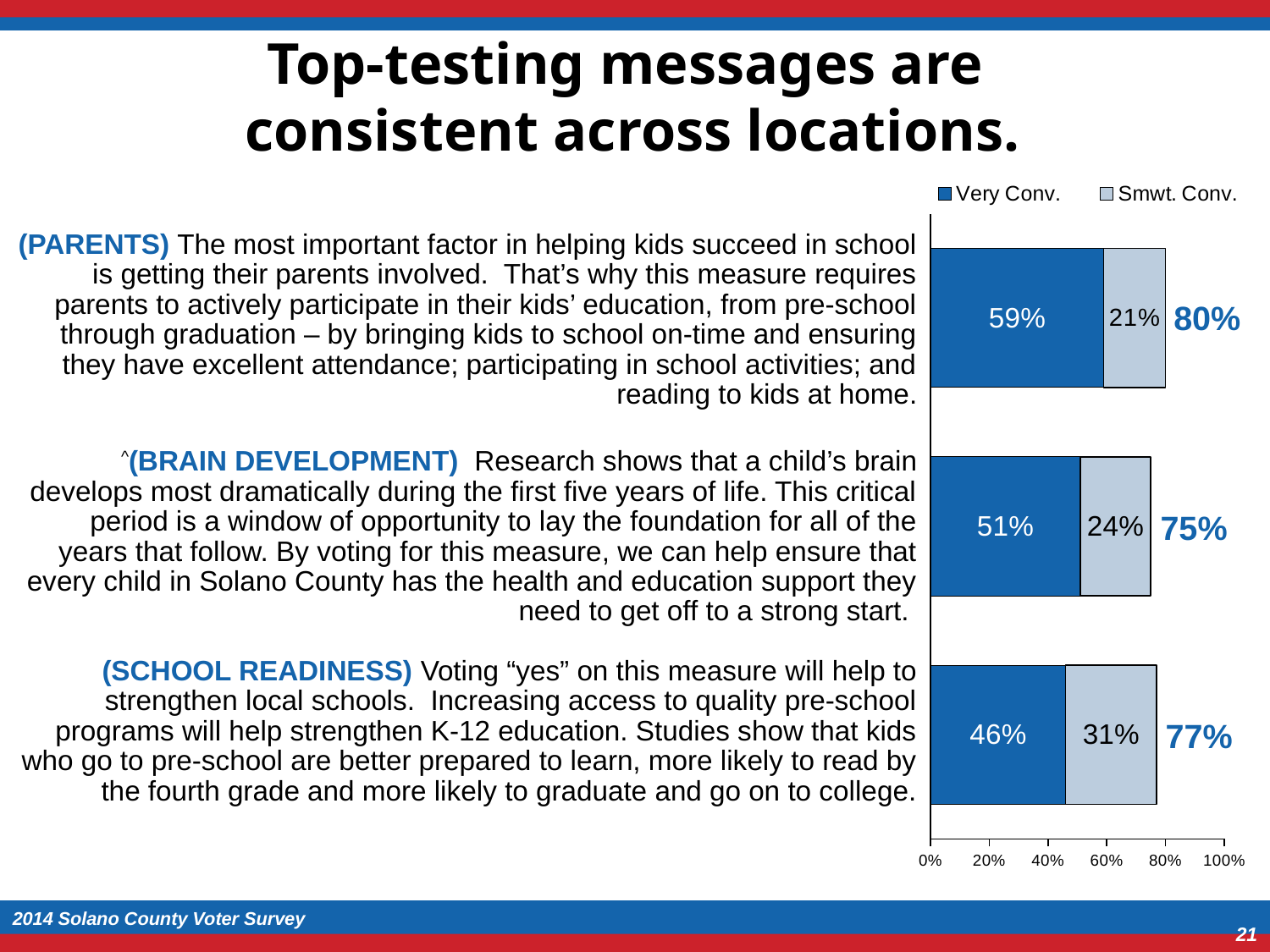
What is the Smwt. Conv. value for the SCHOOL READINESS message? 31% How many messages are shown in the chart? 3 Which message has the highest Very Conv. value? PARENTS How many series does the legend list? 2 What is the Very Conv. value for the PARENTS message? 59% What is the difference between the Very Conv. values for PARENTS and SCHOOL READINESS? 13% Which message has the highest combined total? PARENTS What is the total (Very Conv. plus Smwt. Conv.) for the BRAIN DEVELOPMENT message? 75% Which message has the lowest Very Conv. value? SCHOOL READINESS What kind of chart is shown on the slide? Stacked bar chart Which is larger: the Smwt. Conv. value for SCHOOL READINESS or for PARENTS? SCHOOL READINESS What is the Smwt. Conv. value for the BRAIN DEVELOPMENT message? 24%